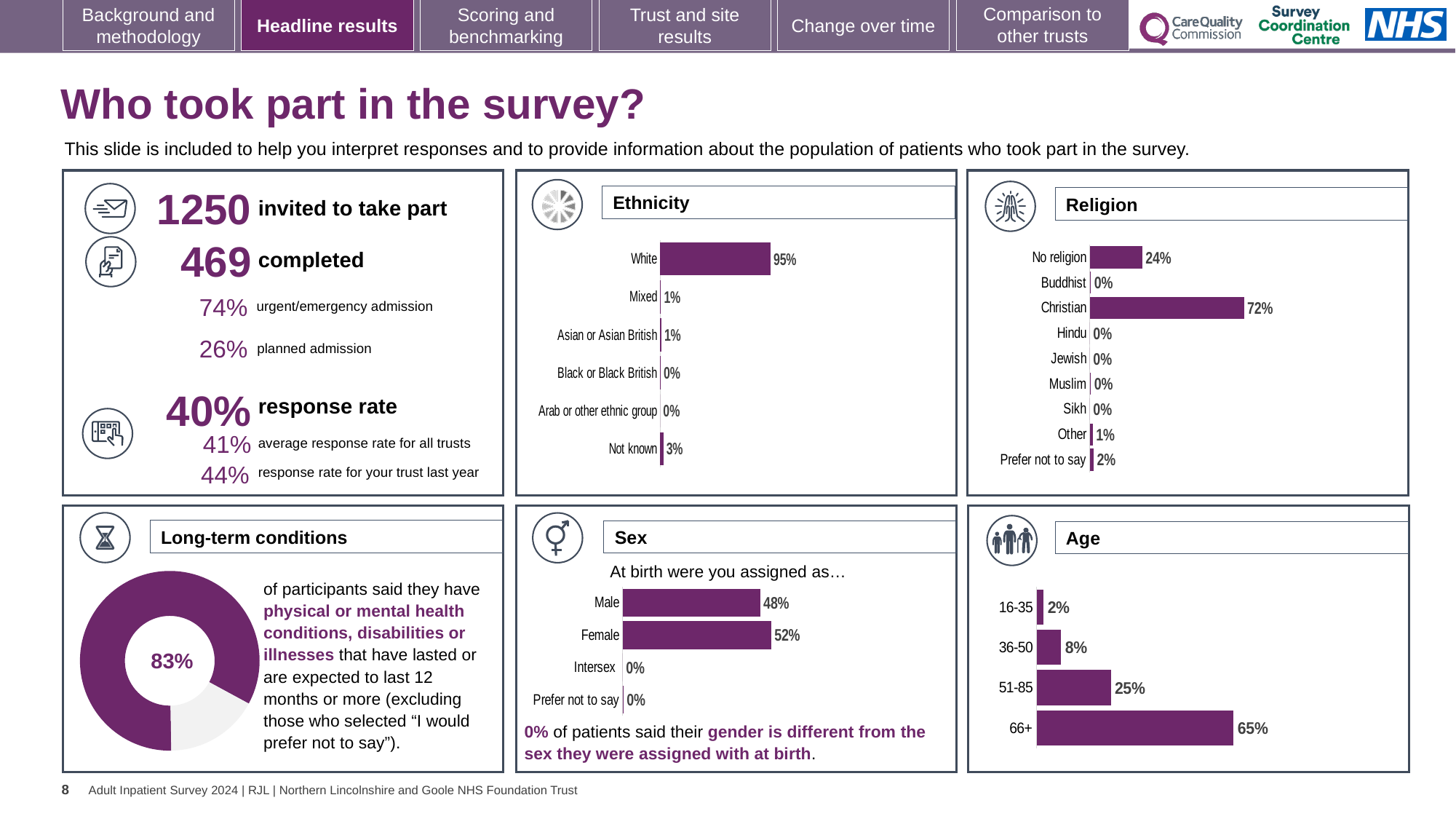
In the Sex chart, which is larger, Male or Female? Female How many categories does the Ethnicity chart show? 6 In the Ethnicity chart, which category has the highest value? White What kind of chart is used in the Long-term conditions panel? donut chart In the Age chart, which age group has the highest value? 66+ In the Religion chart, what is the value for Christian? 72% In the Age chart, do the values rise or fall as the age groups get older? rise In the Ethnicity chart, what percentage of respondents were White? 95% In the Sex chart, what is the value for Male? 48% In the Age chart, what is the value for 36-50? 8% In the Religion chart, what is the value for Prefer not to say? 2% In the Religion chart, what is the difference between the Christian and No religion values? 48%